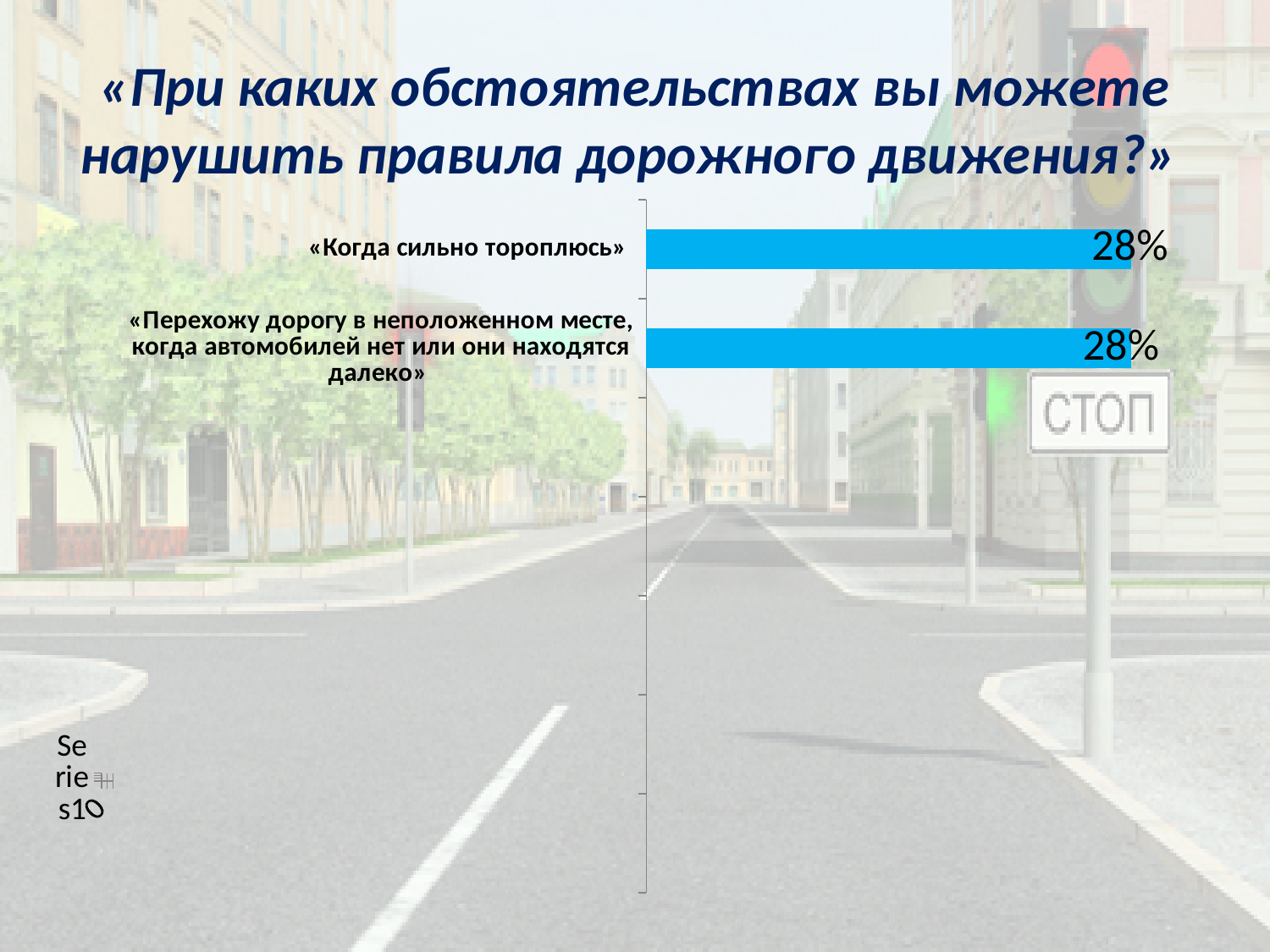
What colour are the bars in the chart? blue What is the value for «Перехожу дорогу в неположенном месте, когда автомобилей нет или они находятся далеко»? 28% Are the bars in the chart horizontal or vertical? horizontal What is the difference between the value for «Когда сильно тороплюсь» and the value for «Перехожу дорогу в неположенном месте, когда автомобилей нет или они находятся далеко»? 0% Is the value for «Когда сильно тороплюсь» greater or less than 20%? greater What kind of chart is shown on the slide? bar chart How many labelled bars are shown in the chart? 2 What is the value for «Когда сильно тороплюсь»? 28%